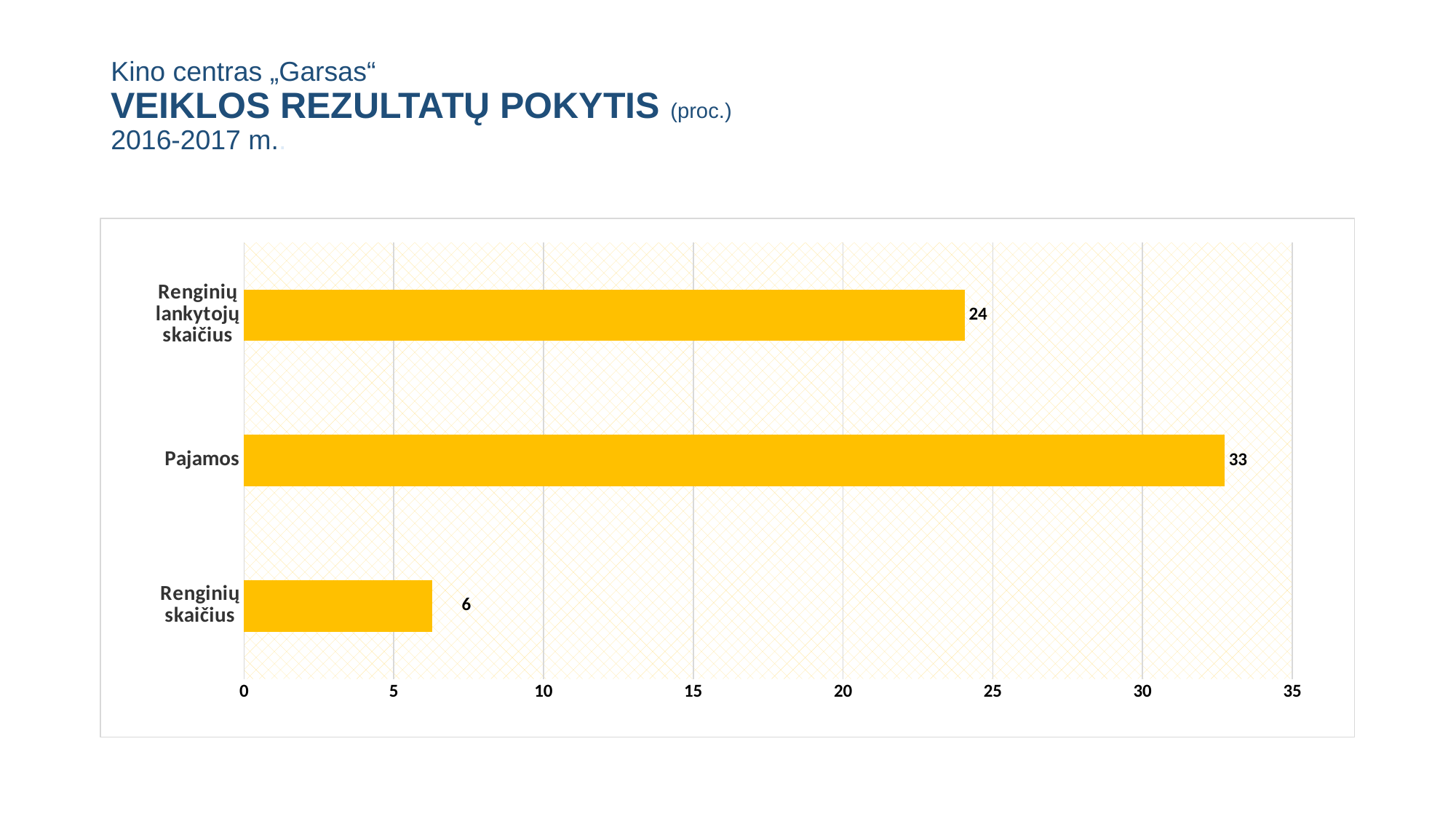
Is the value for Renginių lankytojų skaičius greater or less than 20? greater What is the value for Pajamos? 33 What kind of chart is shown on the slide? bar chart What is the difference between the values for Renginių lankytojų skaičius and Renginių skaičius? 18 Which category has the highest value? Pajamos What is the difference between the values for Pajamos and Renginių lankytojų skaičius? 9 What is the maximum value shown on the horizontal axis? 35 Which category has the lowest value? Renginių skaičius What is the value for Renginių skaičius? 6 What is the value for Renginių lankytojų skaičius? 24 Which is larger, the value for Pajamos or the value for Renginių skaičius? Pajamos How many categories are shown in the chart? 3